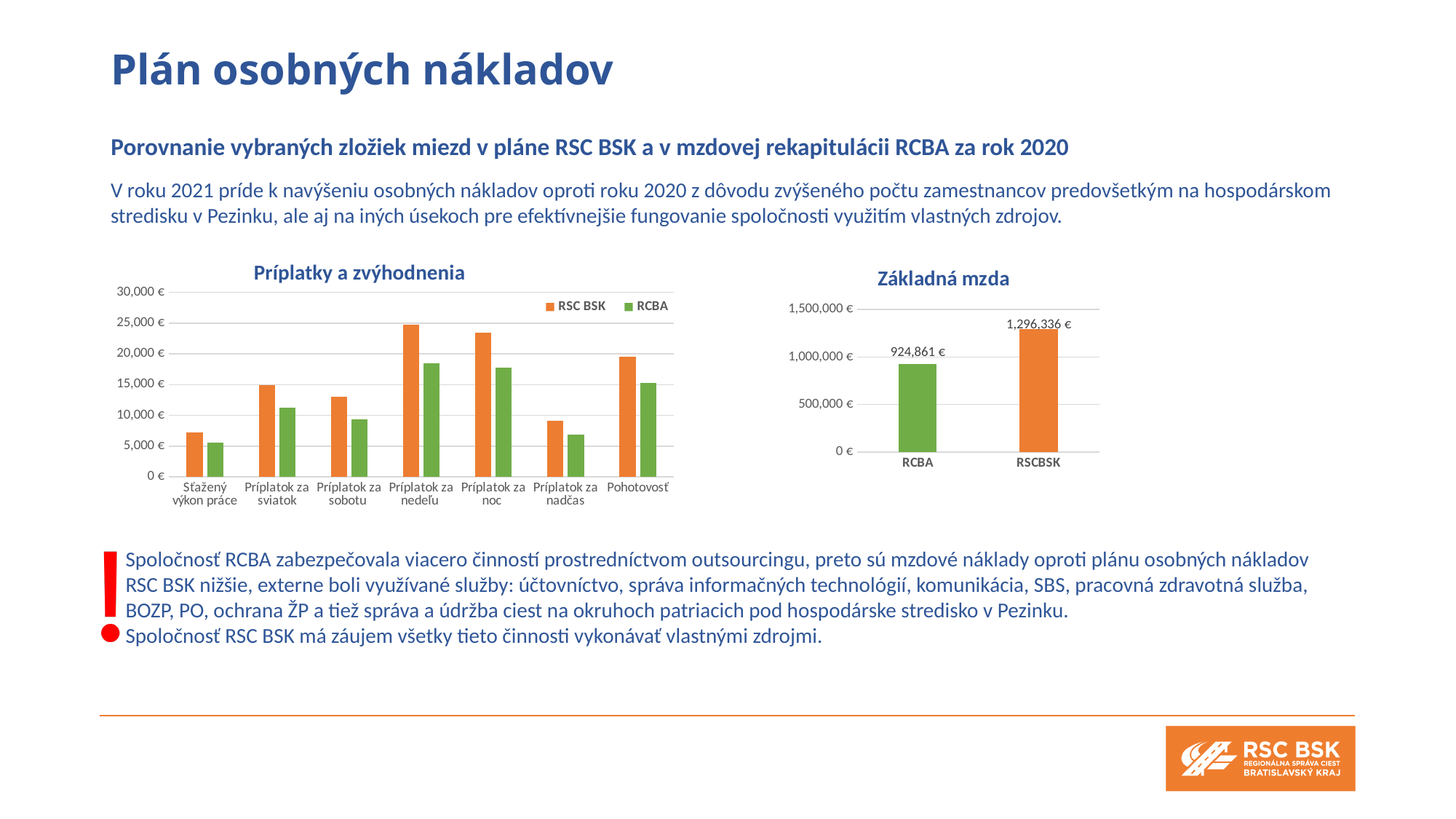
In the 'Príplatky a zvýhodnenia' chart, which category has the lowest RCBA value? Sťažený výkon práce In the 'Príplatky a zvýhodnenia' chart, how many categories are shown on the x axis? 7 What kind of chart is 'Príplatky a zvýhodnenia'? Bar chart In the 'Základná mzda' chart, what is the value for RSCBSK? 1,296,336 € In the 'Základná mzda' chart, how many bars are plotted? 2 In the 'Príplatky a zvýhodnenia' chart, is the RSC BSK value for Príplatok za nedeľu greater or less than 20,000 €? greater In the 'Základná mzda' chart, what is the difference between the RSCBSK and RCBA values? 371,475 € In the 'Príplatky a zvýhodnenia' chart, which colour represents the RCBA series? Green In the 'Základná mzda' chart, which is larger, RCBA or RSCBSK? RSCBSK In the 'Príplatky a zvýhodnenia' chart, how many series does the legend list? 2 In the 'Základná mzda' chart, what is the value for RCBA? 924,861 € In the 'Príplatky a zvýhodnenia' chart, which category has the highest RSC BSK value? Príplatok za nedeľu